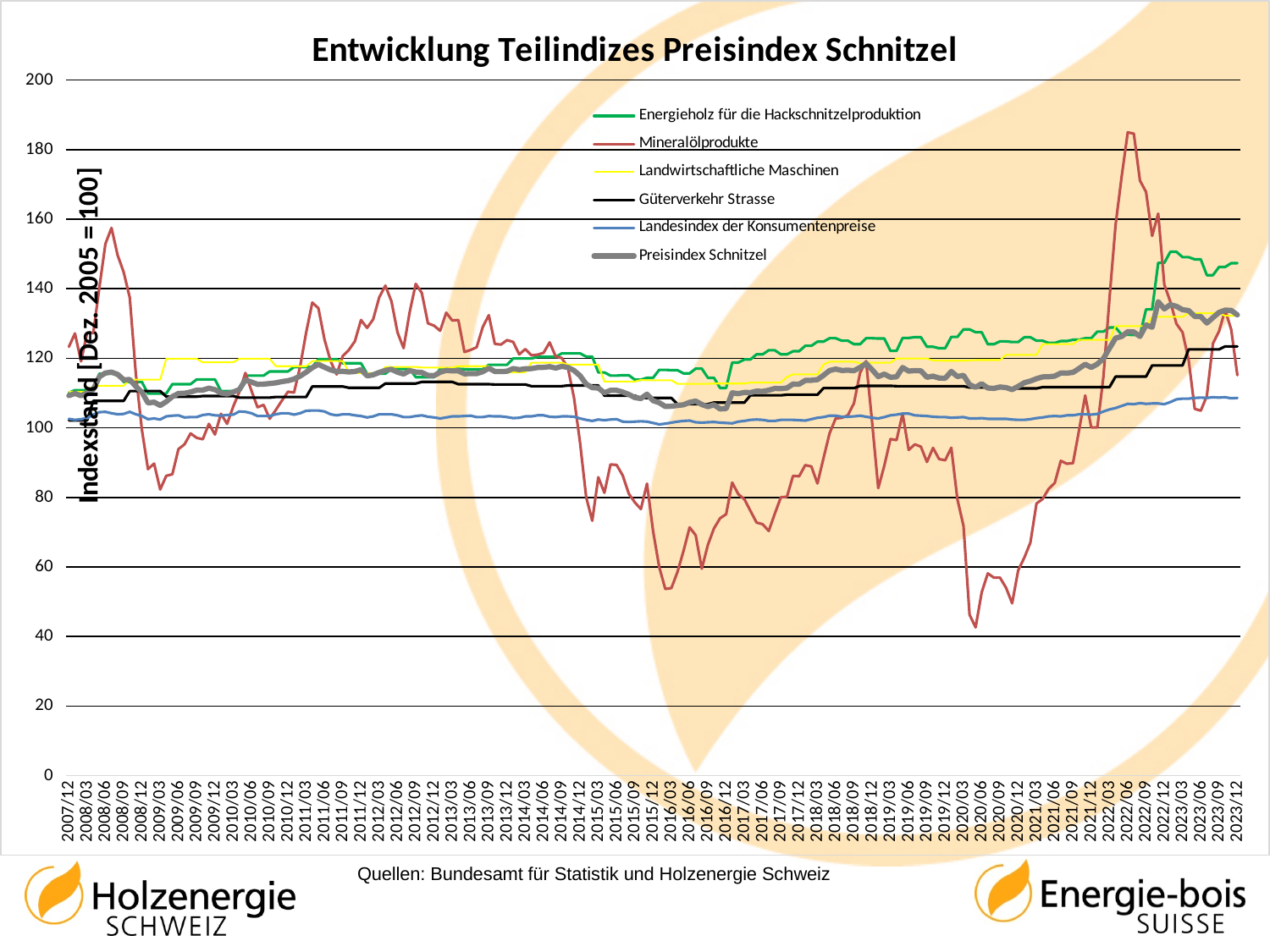
Is the peak value for Mineralölprodukte around 2022/06 greater or less than 160? greater Which series drops to the lowest value anywhere on the chart? Mineralölprodukte Is the value for Energieholz für die Hackschnitzelproduktion at 2023/12 greater or less than 140? greater What is the title of the chart? Entwicklung Teilindizes Preisindex Schnitzel How many series does the legend list? 6 Is the value for Landesindex der Konsumentenpreise at 2023/12 greater or less than 120? less Which series has the highest value at 2023/12? Energieholz für die Hackschnitzelproduktion What is the label of the vertical axis? Indexstand [Dez. 2005 = 100] Which series reaches the highest value anywhere on the chart? Mineralölprodukte What kind of chart is shown on the slide? line chart At 2023/12, which is larger: Energieholz für die Hackschnitzelproduktion or Landesindex der Konsumentenpreise? Energieholz für die Hackschnitzelproduktion